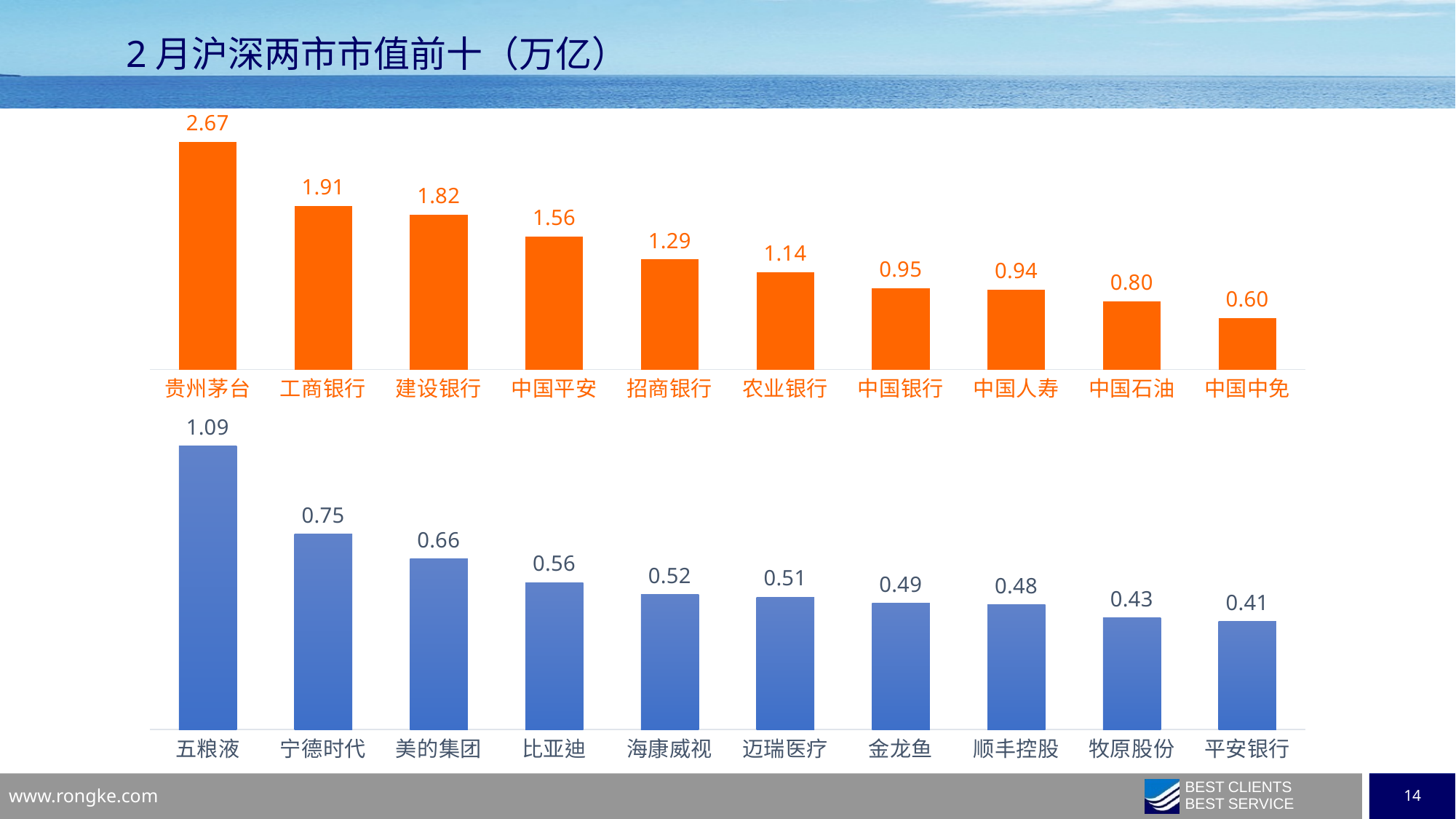
In the top (orange) chart, what is the difference between the values for 工商银行 and 建设银行? 0.09 In the bottom (blue) chart, which category has the highest value? 五粮液 In the top (orange) chart, which is larger, the value for 招商银行 or the value for 农业银行? 招商银行 In the top (orange) chart, what is the value for 贵州茅台? 2.67 In the bottom (blue) chart, what is the difference between the values for 五粮液 and 平安银行? 0.68 In the top (orange) chart, which category has the lowest value? 中国中免 In the top (orange) chart, what is the value for 中国平安? 1.56 What type of chart is the top (orange) chart? bar chart In the bottom (blue) chart, do the values rise or fall from left to right? fall How many categories are shown in the bottom (blue) chart? 10 In the bottom (blue) chart, what is the value for 比亚迪? 0.56 In the bottom (blue) chart, what is the value for 宁德时代? 0.75